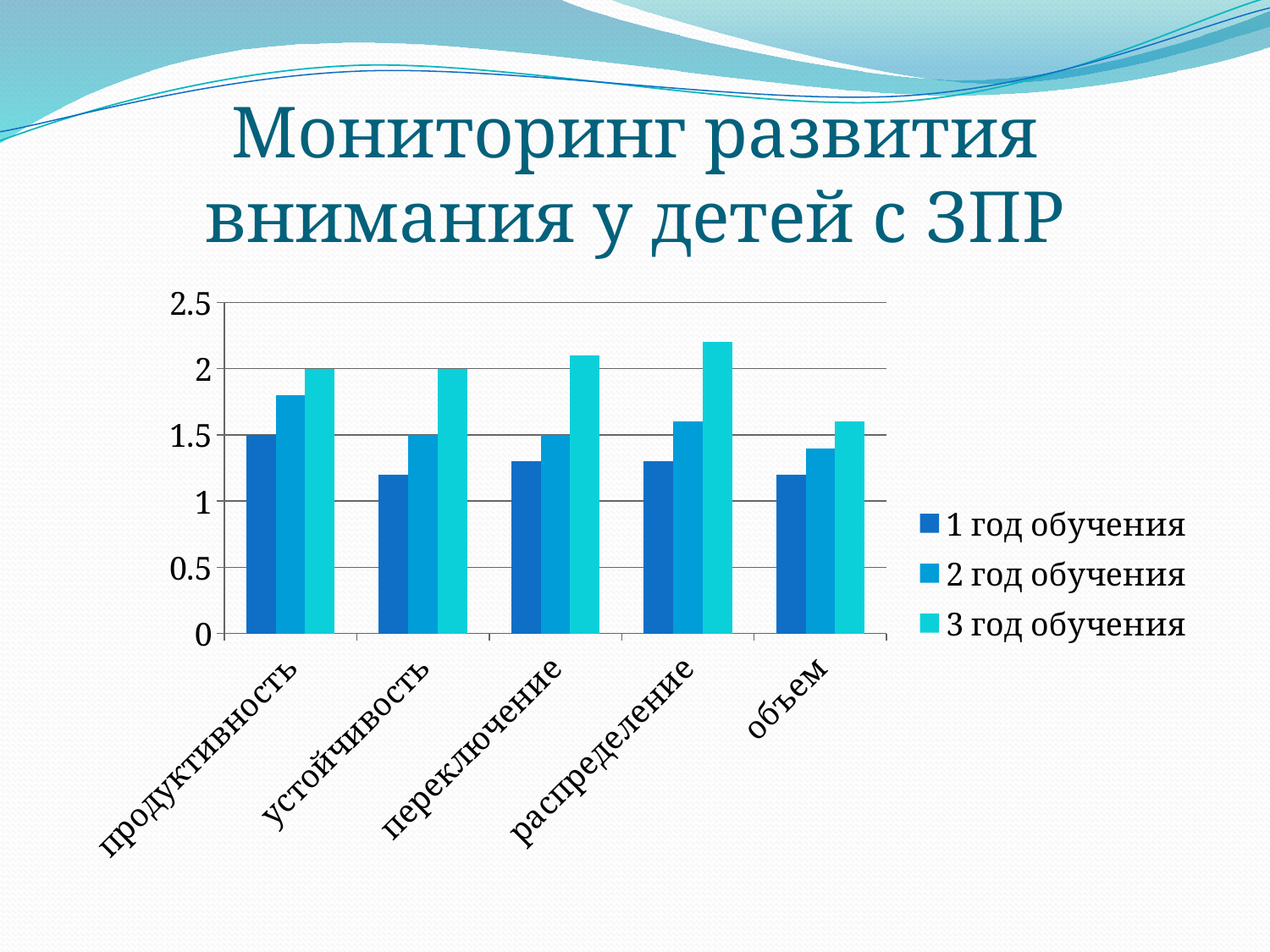
For переключение, which series has the larger value: 1 год обучения or 3 год обучения? 3 год обучения What is the value for продуктивность in the 3 год обучения series? 2 What kind of chart is shown on the slide? bar chart What is the value for устойчивость in the 3 год обучения series? 2 Is the value for объем in the 1 год обучения series greater or less than 1.5? less Which category has the highest value in the 3 год обучения series? распределение How many categories are shown on the x axis? 5 Which category has the lowest value in the 3 год обучения series? объем How many series does the legend list? 3 Is the value for распределение in the 3 год обучения series greater or less than 2? greater Which series is shown in the darkest blue colour? 1 год обучения What is the value for продуктивность in the 1 год обучения series? 1.5